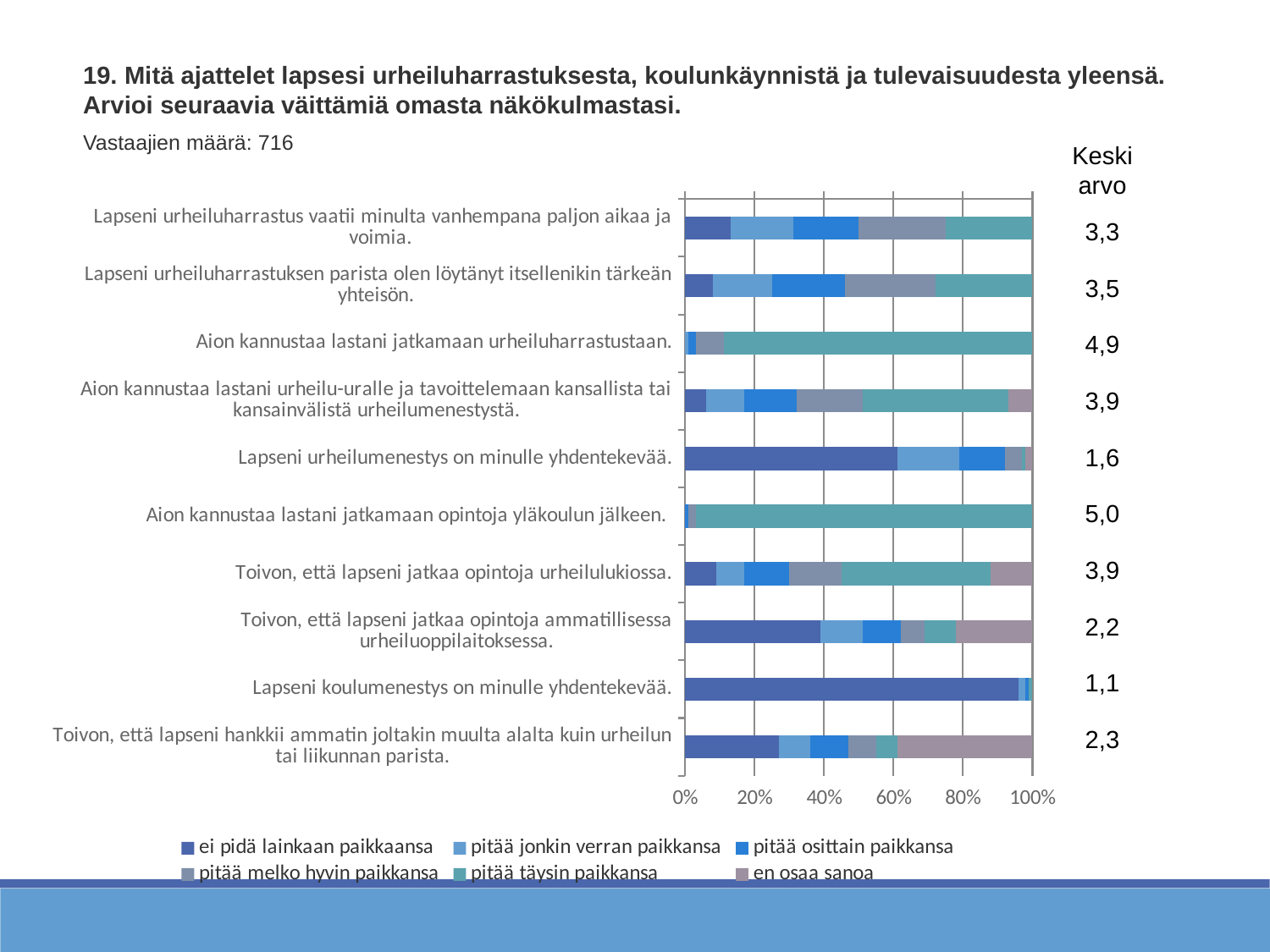
What is the Keskiarvo value for "Aion kannustaa lastani jatkamaan opintoja yläkoulun jälkeen."? 5,0 Which statement has the lowest Keskiarvo value? Lapseni koulumenestys on minulle yhdentekevää. How many series does the legend list? 6 How many statements (categories) are plotted in the chart? 10 Is the "pitää täysin paikkansa" share for "Aion kannustaa lastani jatkamaan urheiluharrastustaan." greater or less than 60%? greater What is the difference between the Keskiarvo values for "Aion kannustaa lastani jatkamaan urheiluharrastustaan." and "Lapseni urheiluharrastus vaatii minulta vanhempana paljon aikaa ja voimia."? 1,6 What kind of chart is shown on the slide? Stacked bar chart How many respondents (Vastaajien määrä) does the slide report? 716 Is the "ei pidä lainkaan paikkaansa" share for "Lapseni koulumenestys on minulle yhdentekevää." greater or less than 80%? greater Which statement has the highest Keskiarvo value? Aion kannustaa lastani jatkamaan opintoja yläkoulun jälkeen. Which has the larger Keskiarvo value: "Lapseni urheiluharrastuksen parista olen löytänyt itsellenikin tärkeän yhteisön." or "Toivon, että lapseni jatkaa opintoja urheilulukiossa."? Toivon, että lapseni jatkaa opintoja urheilulukiossa. What is the Keskiarvo value for "Lapseni urheilumenestys on minulle yhdentekevää."? 1,6